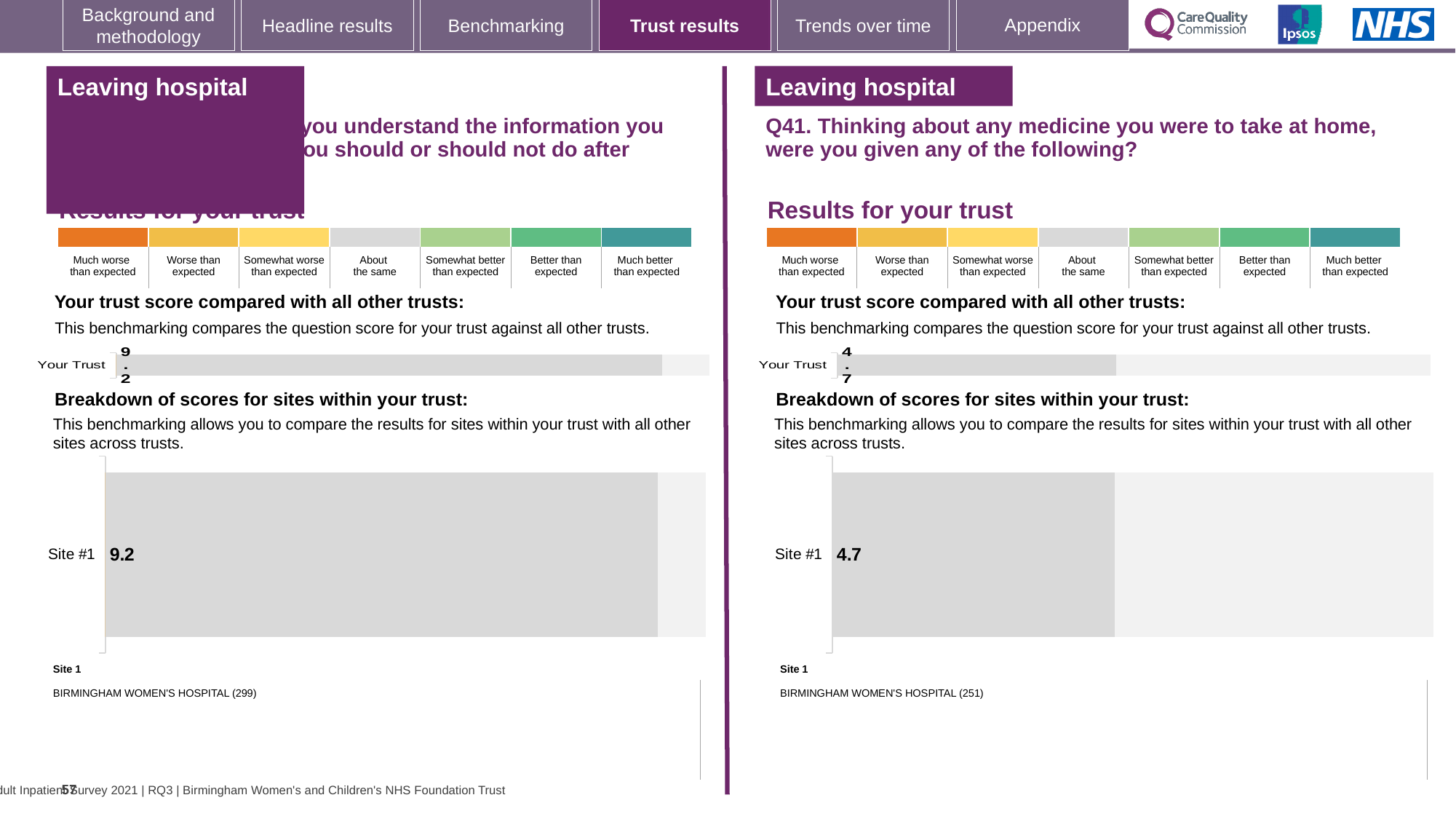
What type of chart is used to show the Your Trust score on the left-hand side of the slide? Bar chart Which site is listed as Site 1 beneath the right-hand breakdown chart? BIRMINGHAM WOMEN'S HOSPITAL (251) On the left-hand side of the slide, what is the value shown for Your Trust in the trust score bar chart? 9.2 Which is larger: the Site #1 score in the left-hand breakdown chart or the Site #1 score in the right-hand breakdown chart? Left-hand chart (9.2) On the right-hand side of the slide (Q41), what is the value shown for Your Trust in the trust score bar chart? 4.7 How many sites are plotted in the right-hand 'Breakdown of scores for sites within your trust' chart? 1 In the left-hand 'Breakdown of scores for sites within your trust' chart, what is the score for Site #1? 9.2 What is the difference between the Site #1 score in the left-hand breakdown chart and the Site #1 score in the right-hand breakdown chart? 4.5 Which site is listed as Site 1 beneath the left-hand breakdown chart? BIRMINGHAM WOMEN'S HOSPITAL (299) What type of chart is used to show the Site #1 score on the right-hand side of the slide? Bar chart In the right-hand 'Breakdown of scores for sites within your trust' chart (Q41), what is the score for Site #1? 4.7 How many sites are plotted in the left-hand 'Breakdown of scores for sites within your trust' chart? 1